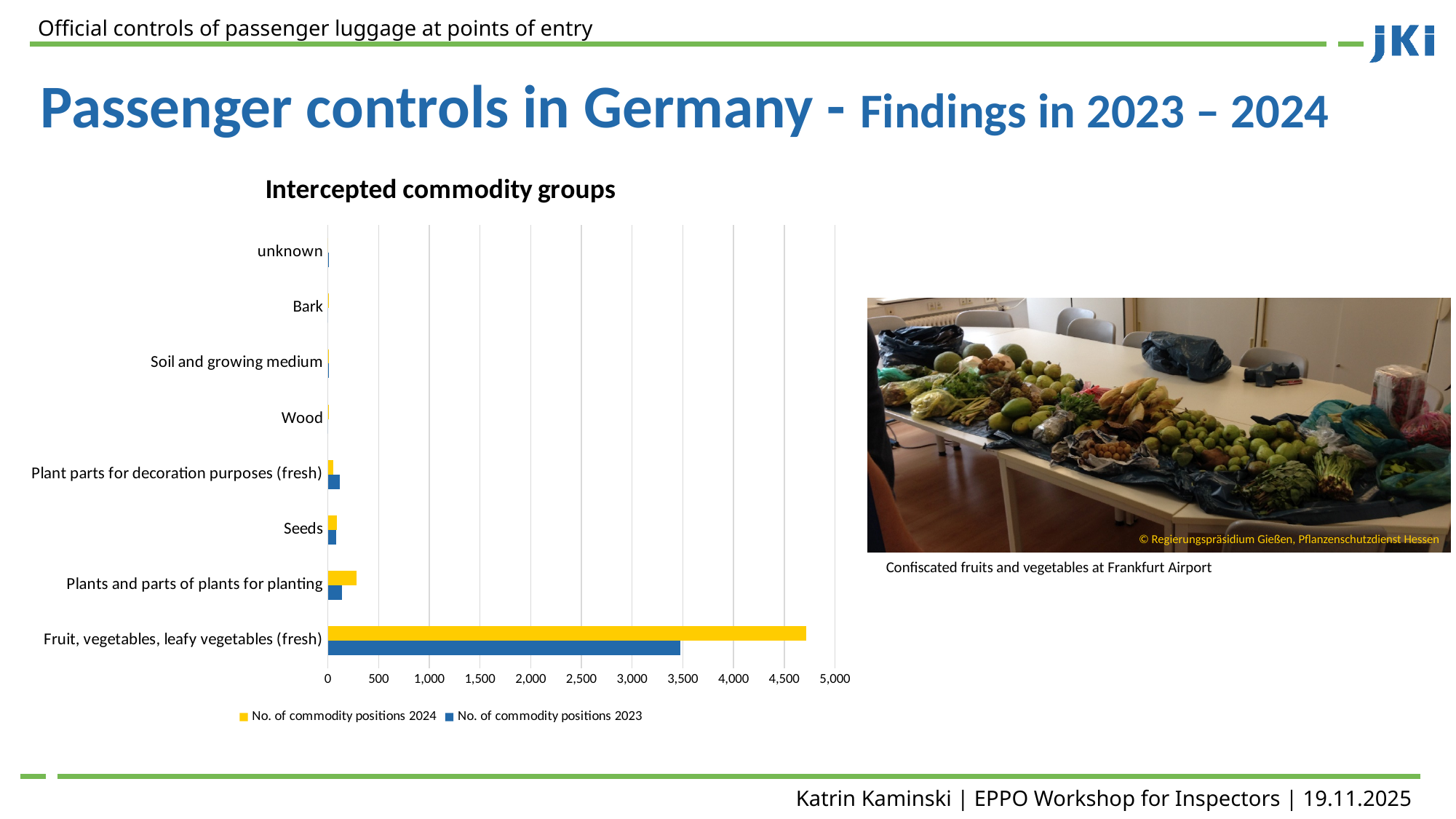
For 'Fruit, vegetables, leafy vegetables (fresh)', which year has the larger number of commodity positions, 2023 or 2024? 2024 What kind of chart is shown on the slide? bar chart Is the 2024 value for 'Fruit, vegetables, leafy vegetables (fresh)' greater or less than 4,500? greater How many series does the chart legend list? 2 Is the 2023 value for 'Fruit, vegetables, leafy vegetables (fresh)' greater or less than 3,000? greater Which commodity group has the highest number of commodity positions in 2023? Fruit, vegetables, leafy vegetables (fresh) What is the title of the chart? Intercepted commodity groups How many commodity groups (categories) are listed on the chart's vertical axis? 8 Is the 2024 value for 'Plants and parts of plants for planting' greater or less than 500? less Which colour represents 'No. of commodity positions 2024' in the chart? yellow Which commodity group has the highest number of commodity positions in 2024? Fruit, vegetables, leafy vegetables (fresh) For 'Plant parts for decoration purposes (fresh)', which year has the larger number of commodity positions, 2023 or 2024? 2023